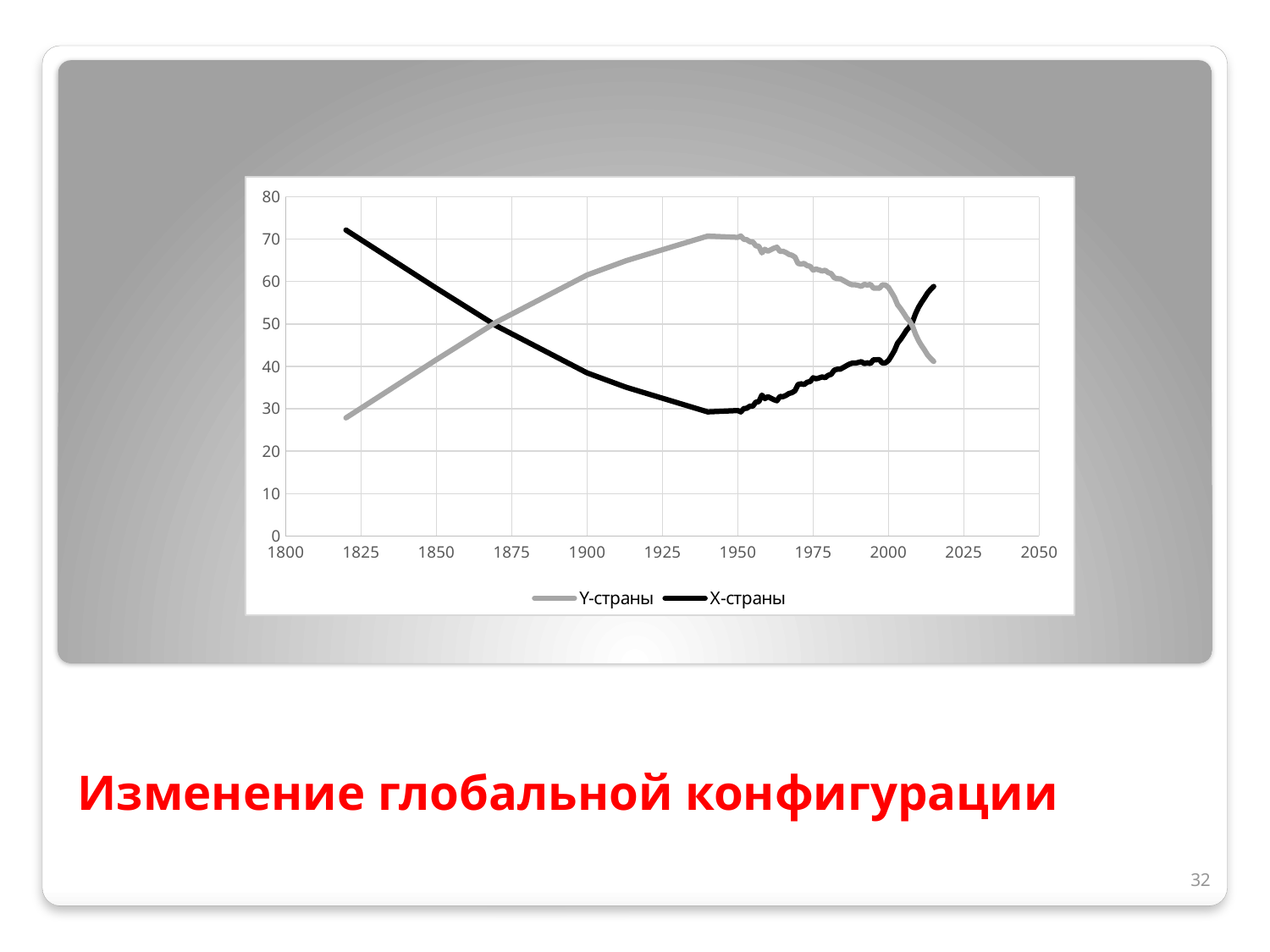
What kind of chart is shown on the slide? line chart Is the value for Y-страны at 1900 greater or less than 50? greater Which series is drawn with the black line? X-страны Which series has the higher value at 1825, Y-страны or X-страны? X-страны Is the value for X-страны at 1950 greater or less than 40? less Is the value for X-страны at 1825 greater or less than 60? greater What are the two series named in the legend? Y-страны and X-страны Which series has the higher value at 1900, Y-страны or X-страны? Y-страны How many series does the legend list? 2 Does the Y-страны line rise or fall between 1825 and 1925? rise Does the X-страны line rise or fall between 1825 and 1950? fall